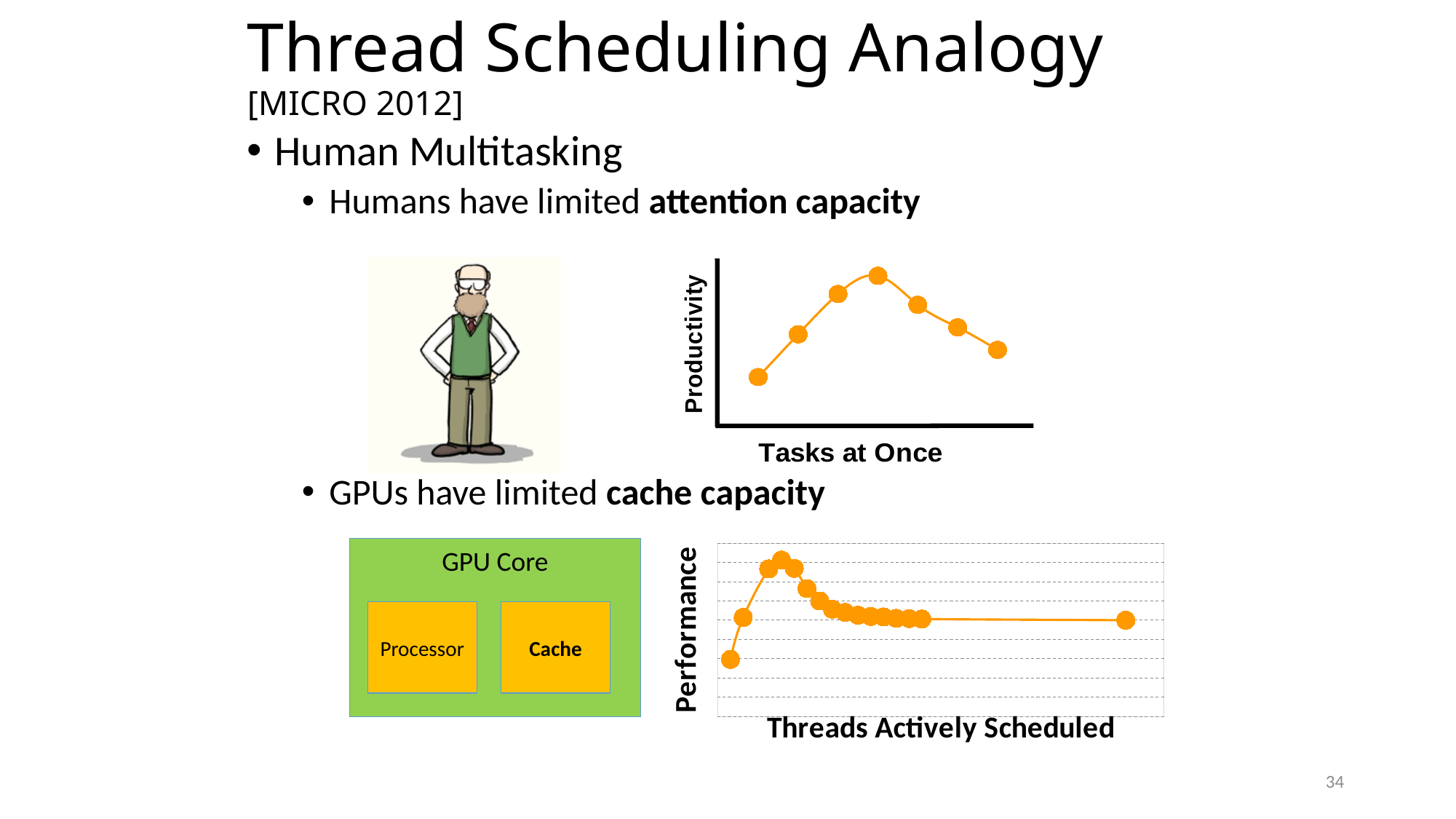
On the top chart (Productivity vs Tasks at Once), which data point is the highest? the fourth point What kind of chart is the top chart with the x axis labelled 'Tasks at Once'? line chart On the bottom chart (Performance vs Threads Actively Scheduled), which data point is the lowest? the first (leftmost) point What kind of chart is the bottom chart with the x axis labelled 'Threads Actively Scheduled'? line chart How many data points are plotted on the top chart (Productivity vs Tasks at Once)? 7 On the top chart (Productivity vs Tasks at Once), which is higher: the first point or the last point? the last point On the top chart (Productivity vs Tasks at Once), what is the label of the y axis? Productivity On the top chart (Productivity vs Tasks at Once), which data point is the lowest? the first (leftmost) point On the bottom chart (Performance vs Threads Actively Scheduled), which is higher: the first point or the last (rightmost) point? the last point On the bottom chart (Performance vs Threads Actively Scheduled), how does performance change as threads actively scheduled increase? rises sharply to a peak, then declines and levels off On the bottom chart (Performance vs Threads Actively Scheduled), what is the label of the x axis? Threads Actively Scheduled On the top chart (Productivity vs Tasks at Once), how does productivity change as tasks at once increase? rises to a peak, then falls